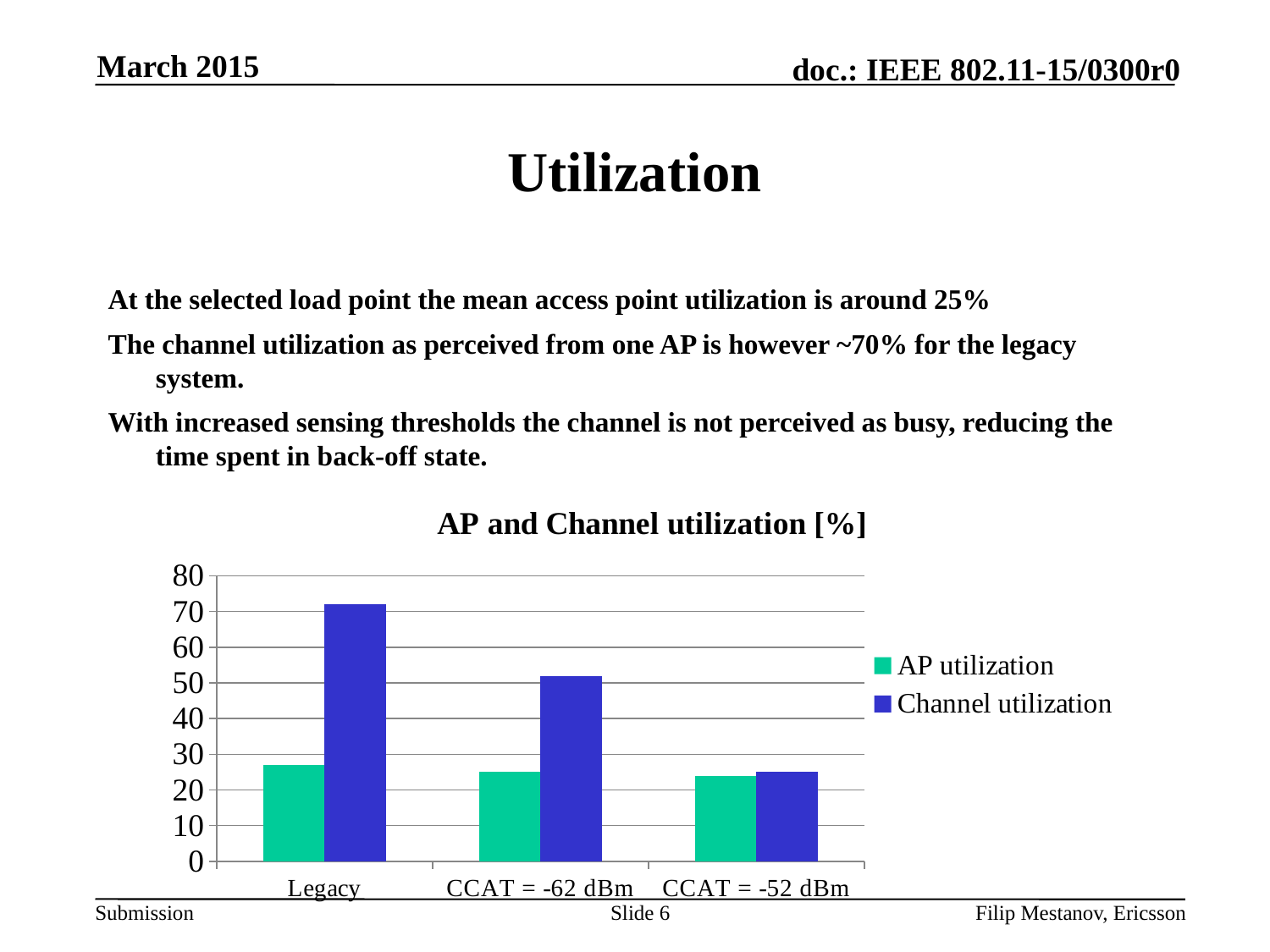
Is the Channel utilization value for CCAT = -52 dBm greater or less than 30? less Does Channel utilization rise or fall moving from Legacy to CCAT = -52 dBm along the x axis? fall Is the Channel utilization value for Legacy greater or less than 60? greater For which category is Channel utilization lowest? CCAT = -52 dBm For the Legacy category, which is larger: AP utilization or Channel utilization? Channel utilization How many categories are shown on the x axis? 3 For which category is Channel utilization highest? Legacy Is the Channel utilization value for CCAT = -62 dBm greater or less than 40? greater What kind of chart is shown on the slide? bar chart How many series does the legend list? 2 Which colour represents AP utilization in the chart? green What is the title of the chart? AP and Channel utilization [%]